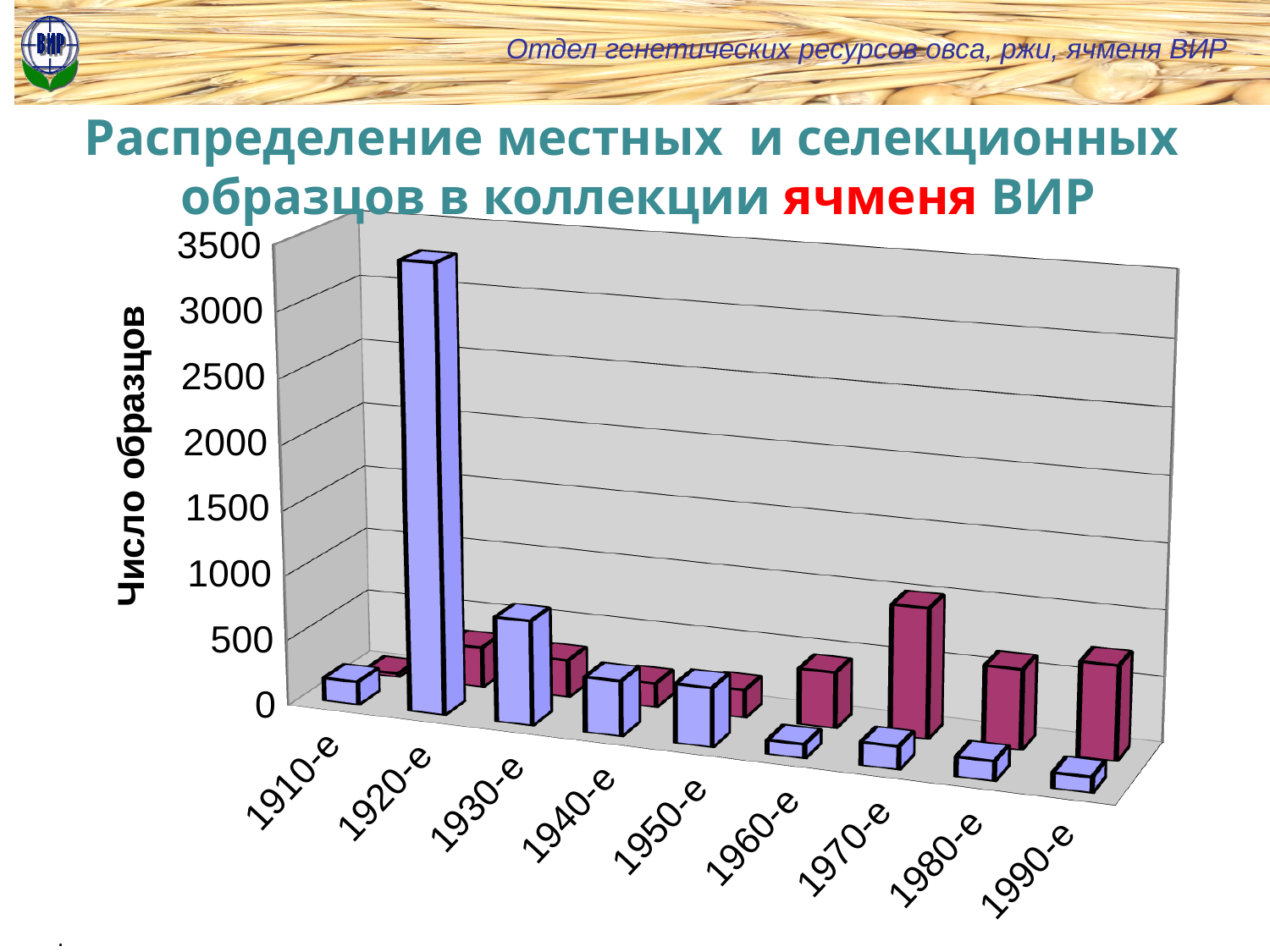
Which light blue bar is taller, 1920-е or 1930-е? 1920-е Which decade has the tallest bar in the chart? 1920-е How many decade categories are shown on the x axis of the chart? 9 Is the value of the light blue bar for 1930-е greater or less than 1000? less What kind of chart is shown on the slide? bar chart Is the value of the light blue bar for 1920-е greater or less than 3000? greater What is the highest value shown on the vertical axis of the chart? 3500 What is the title of the vertical axis of the chart? Число образцов Is the value of the dark pink bar for 1970-е greater or less than 1500? less Do the light blue bars generally rise or fall from 1920-е to 1990-е? fall Which dark pink bar is taller, 1960-е or 1970-е? 1970-е